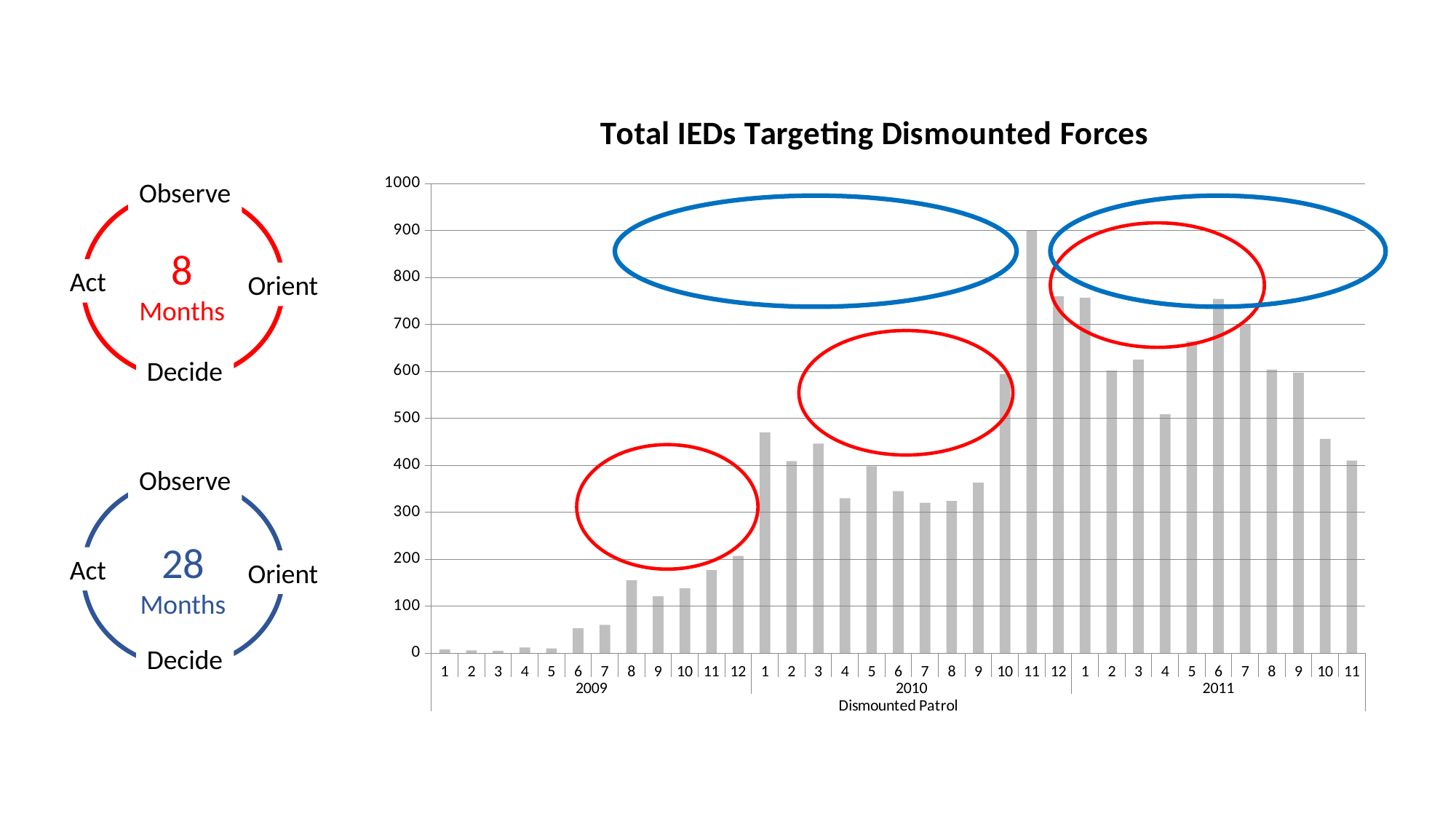
Is the value for month 6 of 2010 greater or less than 400? less How many bars (months) are plotted in the chart? 35 Which is larger, the value for month 11 of 2010 or the value for month 1 of 2011? Month 11 of 2010 Is the value for month 1 of 2011 greater or less than 700? greater Is the value for month 1 of 2009 greater or less than 100? less What label appears below the x axis of the chart? Dismounted Patrol What kind of chart is shown on the slide? bar chart Do the values generally rise or fall across the months of 2009? rise What is the title of the chart? Total IEDs Targeting Dismounted Forces Which month has the highest bar in the chart? Month 11 of 2010